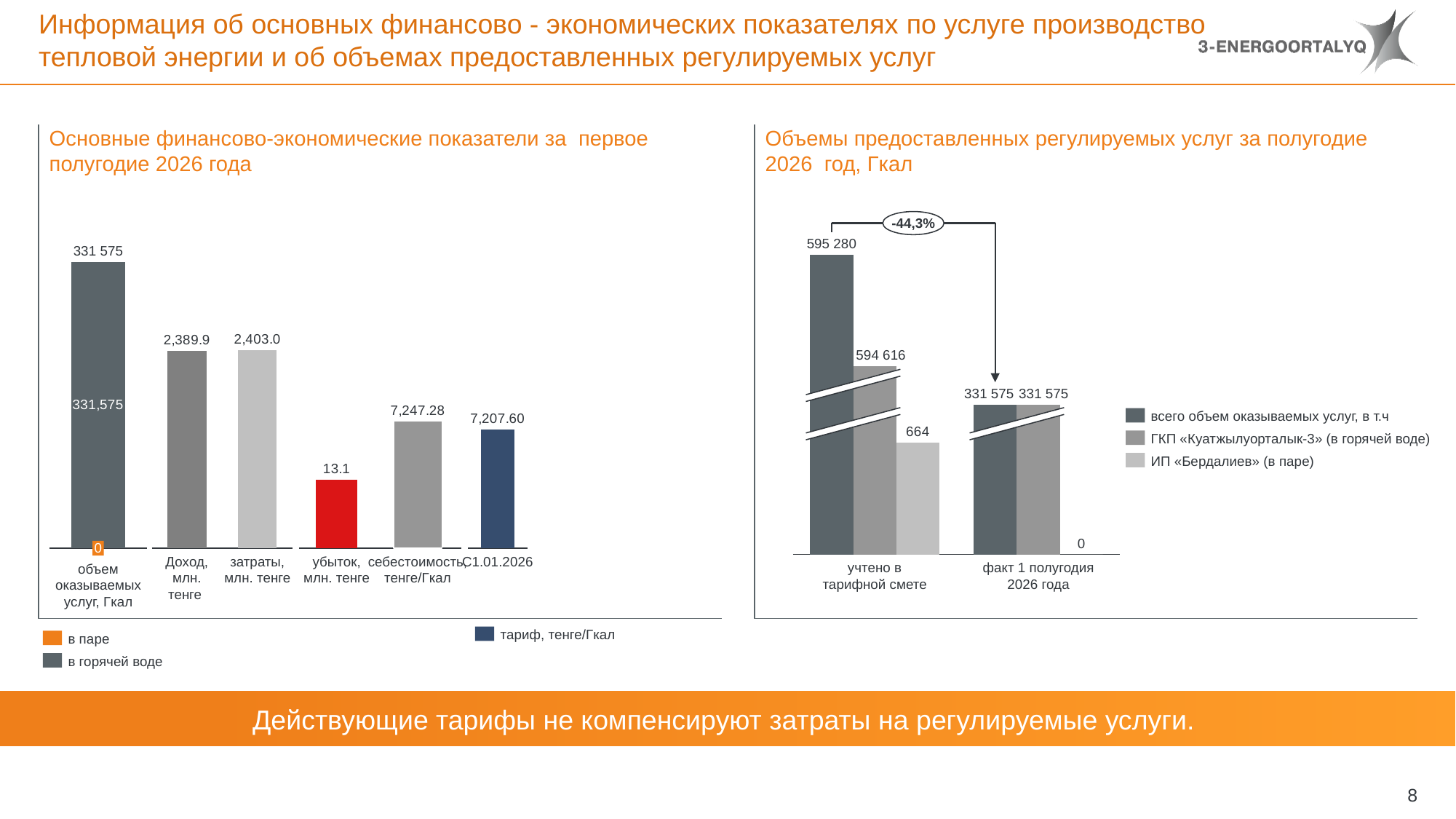
On the left chart (Основные финансово-экономические показатели), what is the value for себестоимость, тенге/Гкал? 7,247.28 On the left chart (Основные финансово-экономические показатели), what is the value for затраты, млн. тенге? 2,403.0 On the left chart (Основные финансово-экономические показатели), what is the value for Доход, млн. тенге? 2,389.9 On the left chart (Основные финансово-экономические показатели), which is larger: Доход or затраты (both in млн. тенге)? затраты On the left chart (Основные финансово-экономические показатели), what is the value for убыток, млн. тенге? 13.1 On the left chart (Основные финансово-экономические показатели), what is the value of the тариф, тенге/Гкал bar (с 1.01.2026)? 7,207.60 On the right chart (Объемы предоставленных регулируемых услуг), what is the value of всего объем оказываемых услуг for учтено в тарифной смете? 595 280 On the left chart (Основные финансово-экономические показатели), what is the difference between затраты and Доход in млн. тенге? 13.1 On the right chart (Объемы предоставленных регулируемых услуг), what is the value for ИП «Бердалиев» (в паре) under учтено в тарифной смете? 664 On the right chart (Объемы предоставленных регулируемых услуг), how many series does the legend list? 3 On the right chart (Объемы предоставленных регулируемых услуг), what is the difference between всего объем оказываемых услуг for учтено в тарифной смете and for факт 1 полугодия 2026 года? 263 705 On the right chart (Объемы предоставленных регулируемых услуг), what percentage change is shown in the annotation between the two categories? -44,3%